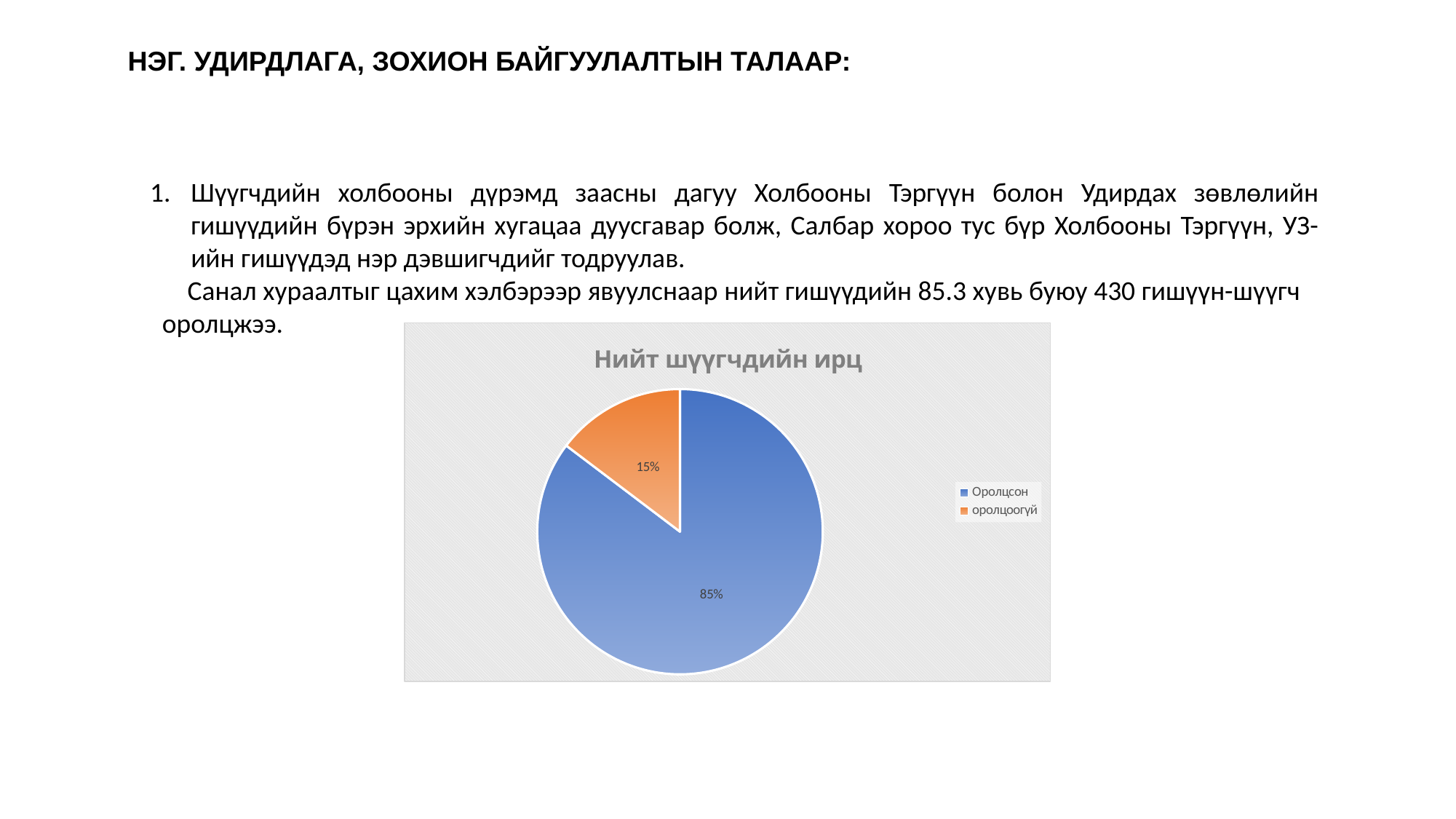
What share of the pie does the "оролцоогүй" slice represent? 15% Which is larger, the "Оролцсон" slice or the "оролцоогүй" slice? Оролцсон What share of the pie does the "Оролцсон" slice represent? 85% How many entries does the legend list? 2 What kind of chart is shown on the slide? pie chart Which slice of the pie is the smallest? оролцоогүй What is the difference in percentage points between the "Оролцсон" and "оролцоогүй" slices? 70% What is the title of the chart? Нийт шүүгчдийн ирц How many slices does the pie chart have? 2 Which slice of the pie is the largest? Оролцсон What colour is the "оролцоогүй" slice? orange